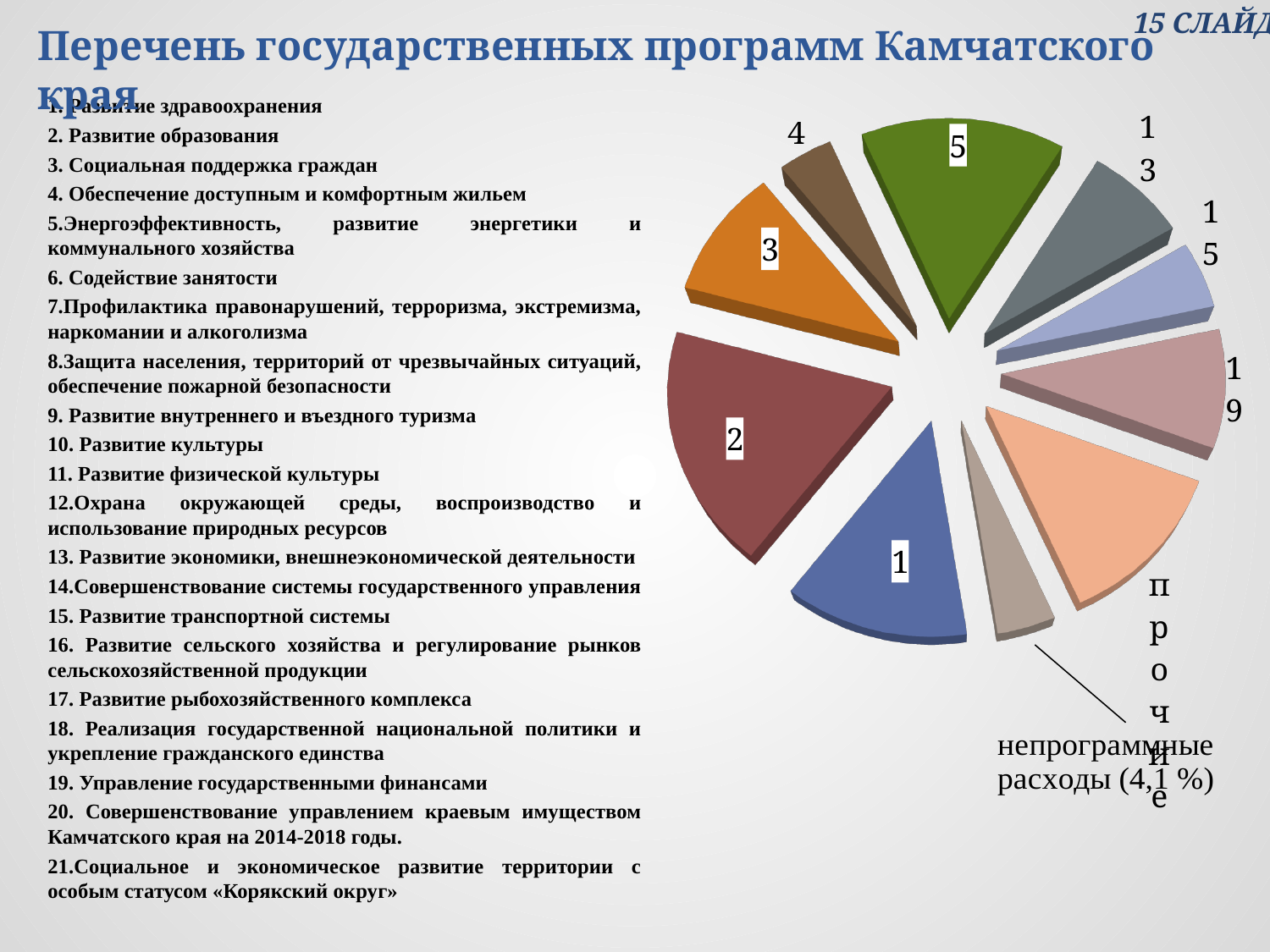
What is the title of the slide containing the pie chart? Перечень государственных программ Камчатского края Which slice is larger, slice 3 or slice 15? 3 Which slice is larger, slice 5 or slice 13? 5 What share of the pie is labelled as непрограммные расходы? 4,1 % How many slices does the pie chart have? 10 Which slice is larger, slice 1 or slice 4? 1 What colour is slice 5 in the pie chart? Green What kind of chart is shown on the slide? Pie chart Which slice of the pie chart is the largest? 2